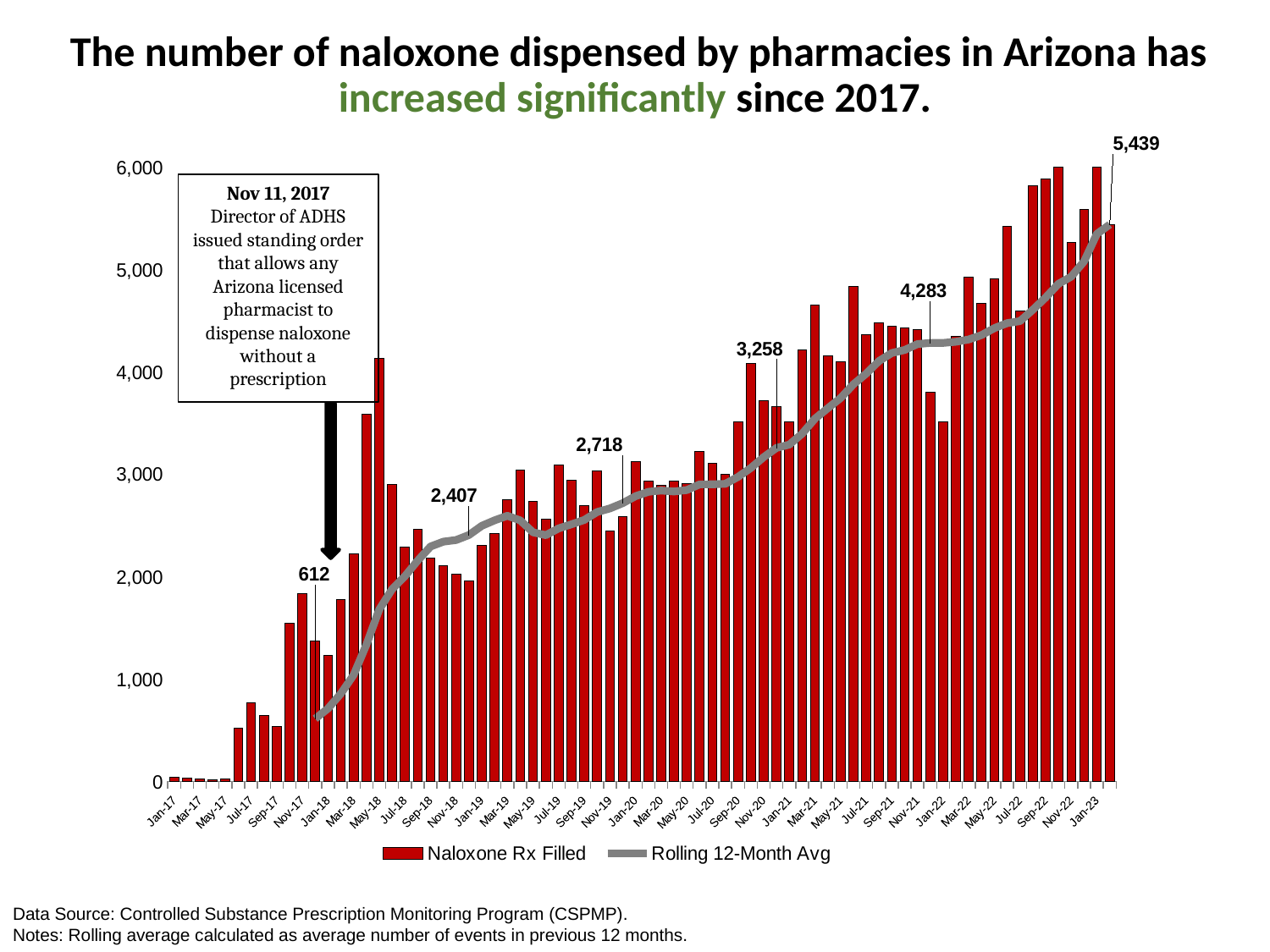
Is the Naloxone Rx Filled value for Jan-17 greater or less than 1,000? less On what date did the Director of ADHS issue the standing order noted in the chart annotation? Nov 11, 2017 Is the Naloxone Rx Filled value for Jan-23 greater or less than 5,000? greater How many series does the legend list? 2 Overall, do the Naloxone Rx Filled values rise or fall from Jan-17 to Jan-23? rise